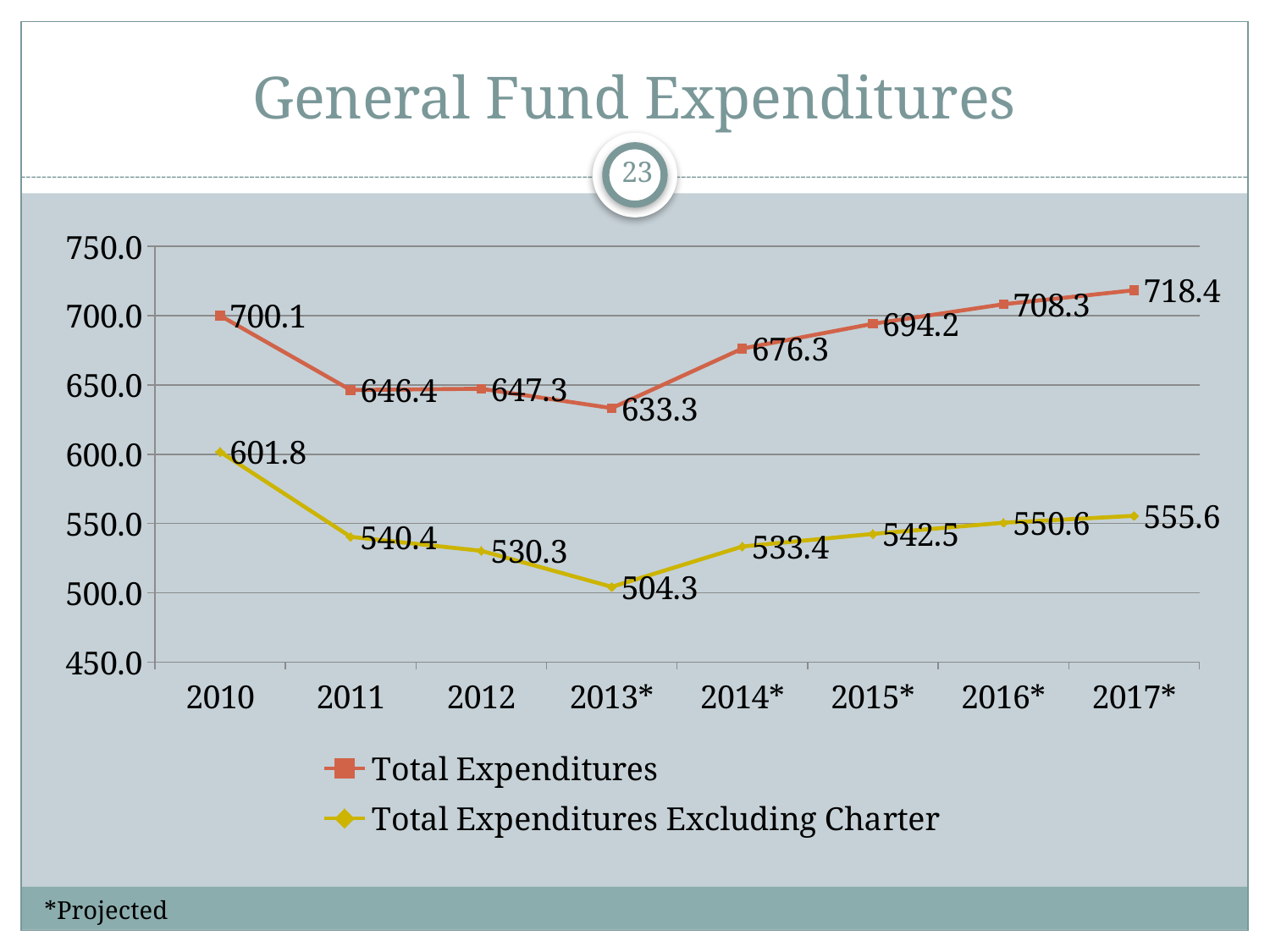
What is the value of Total Expenditures Excluding Charter in 2013*? 504.3 What kind of chart is shown on the slide? Line chart How many series does the legend list? 2 What is the value of Total Expenditures in 2010? 700.1 In which year is Total Expenditures Excluding Charter lowest? 2013* Which is larger: Total Expenditures in 2011 or in 2012? 2012 Does Total Expenditures rise or fall from 2013* to 2017*? Rise In which year is Total Expenditures highest? 2017* How many years are shown on the x axis? 8 Is the value for Total Expenditures in 2013* greater or less than 650.0? less What is the difference between Total Expenditures and Total Expenditures Excluding Charter in 2017*? 162.8 What is the value of Total Expenditures in 2017*? 718.4